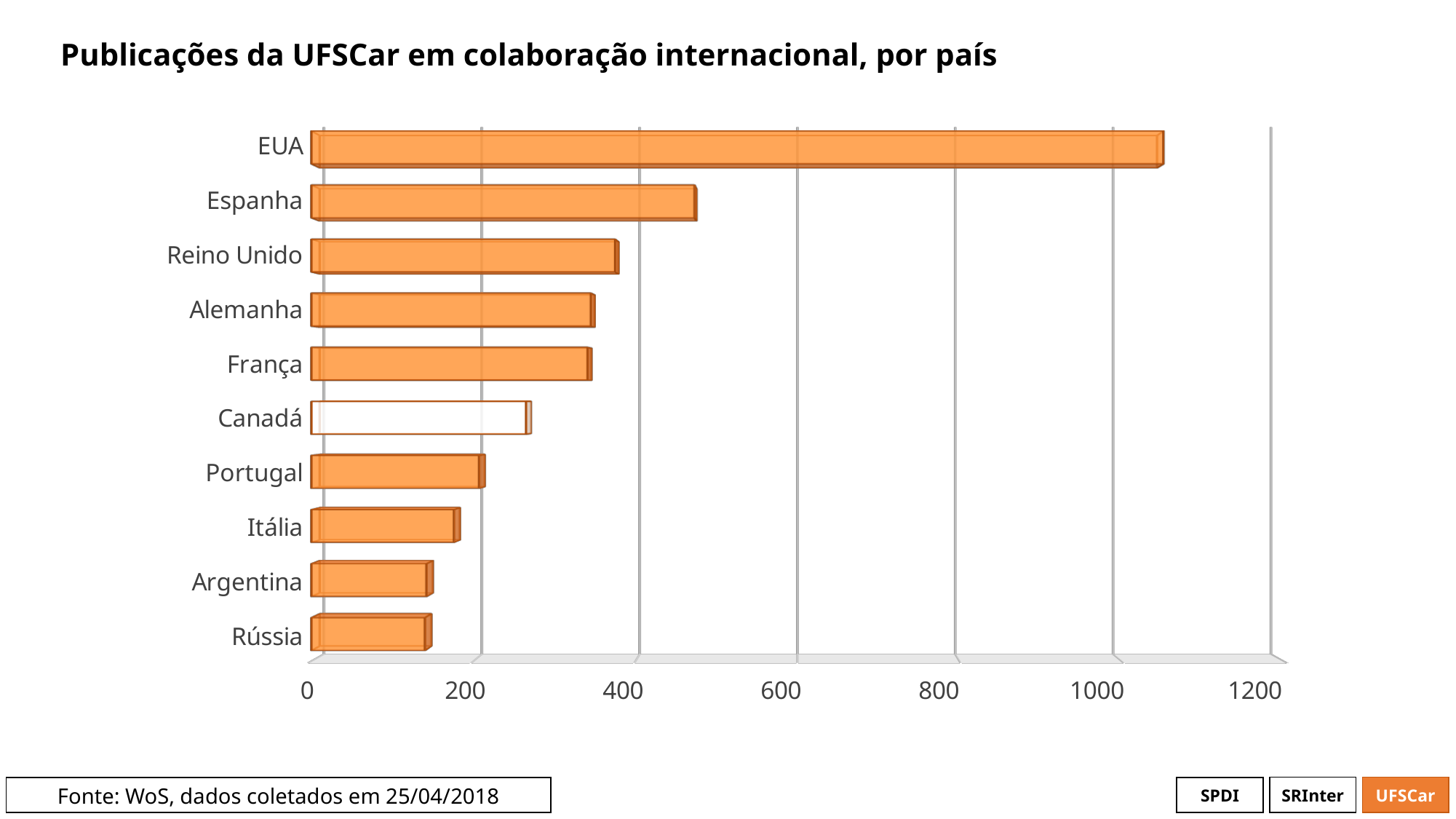
How many countries are shown in the chart? 10 Which has a larger value, Espanha or Reino Unido? Espanha Which has a larger value, Canadá or Portugal? Canadá Is the value for Rússia greater or less than 200? less What type of chart is shown on the slide? bar chart Do the bar values increase or decrease going from the top country to the bottom country? decrease Is the value for Reino Unido greater or less than 400? less What is the title of the chart? Publicações da UFSCar em colaboração internacional, por país Is the value for Espanha greater or less than 600? less Which country has the highest number of publications in international collaboration with UFSCar? EUA